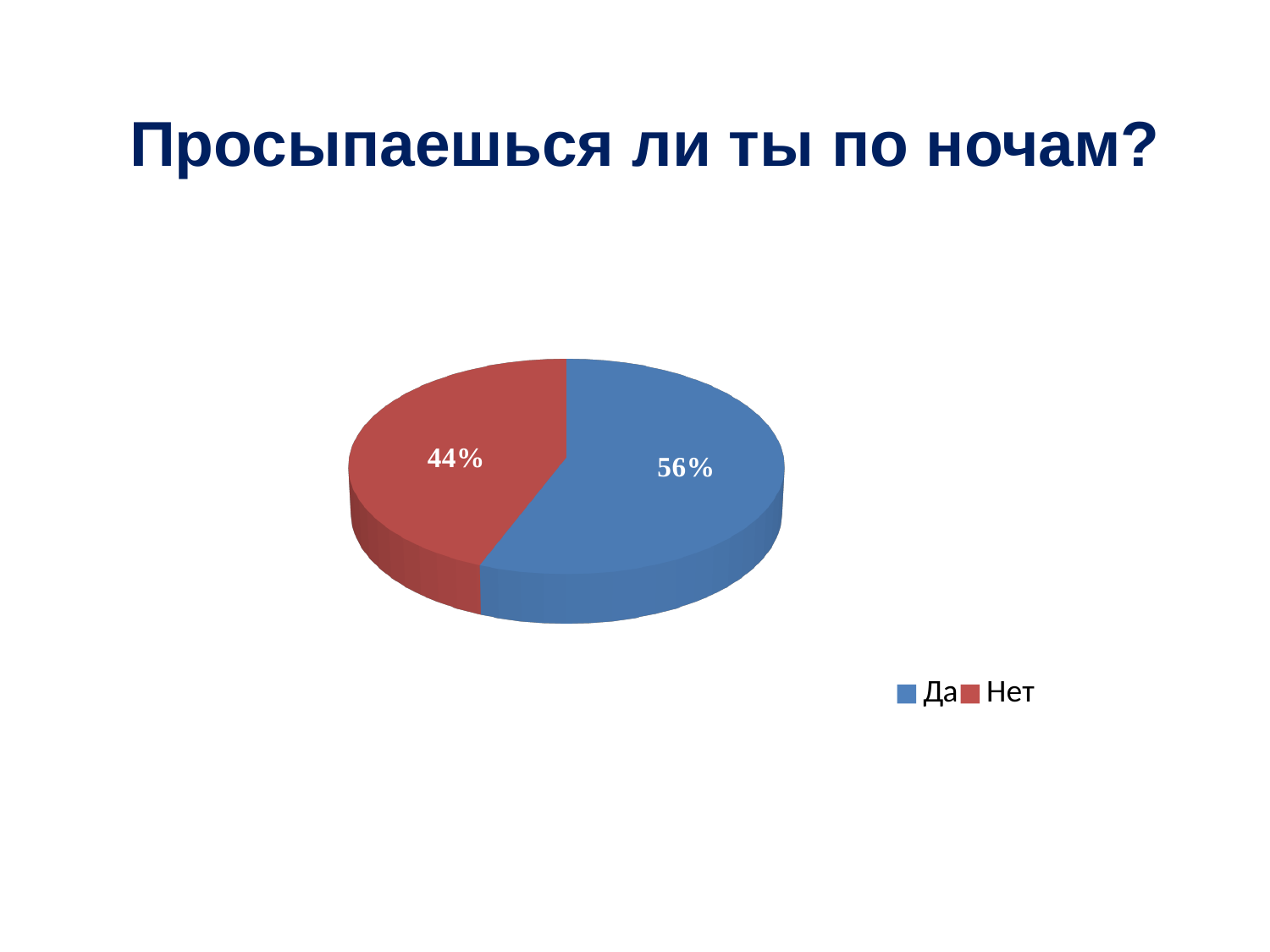
What share of the pie does "Да" have? 56% What is the difference between the "Да" and "Нет" shares? 12% What share of the pie does "Нет" have? 44% How many entries does the legend list? 2 Which is larger, the "Да" slice or the "Нет" slice? Да How many slices does the pie chart have? 2 What colour is the "Нет" slice? red Which slice is the smallest? Нет What is the title of the slide above the chart? Просыпаешься ли ты по ночам? Which slice is the largest? Да What kind of chart is shown on the slide? pie chart